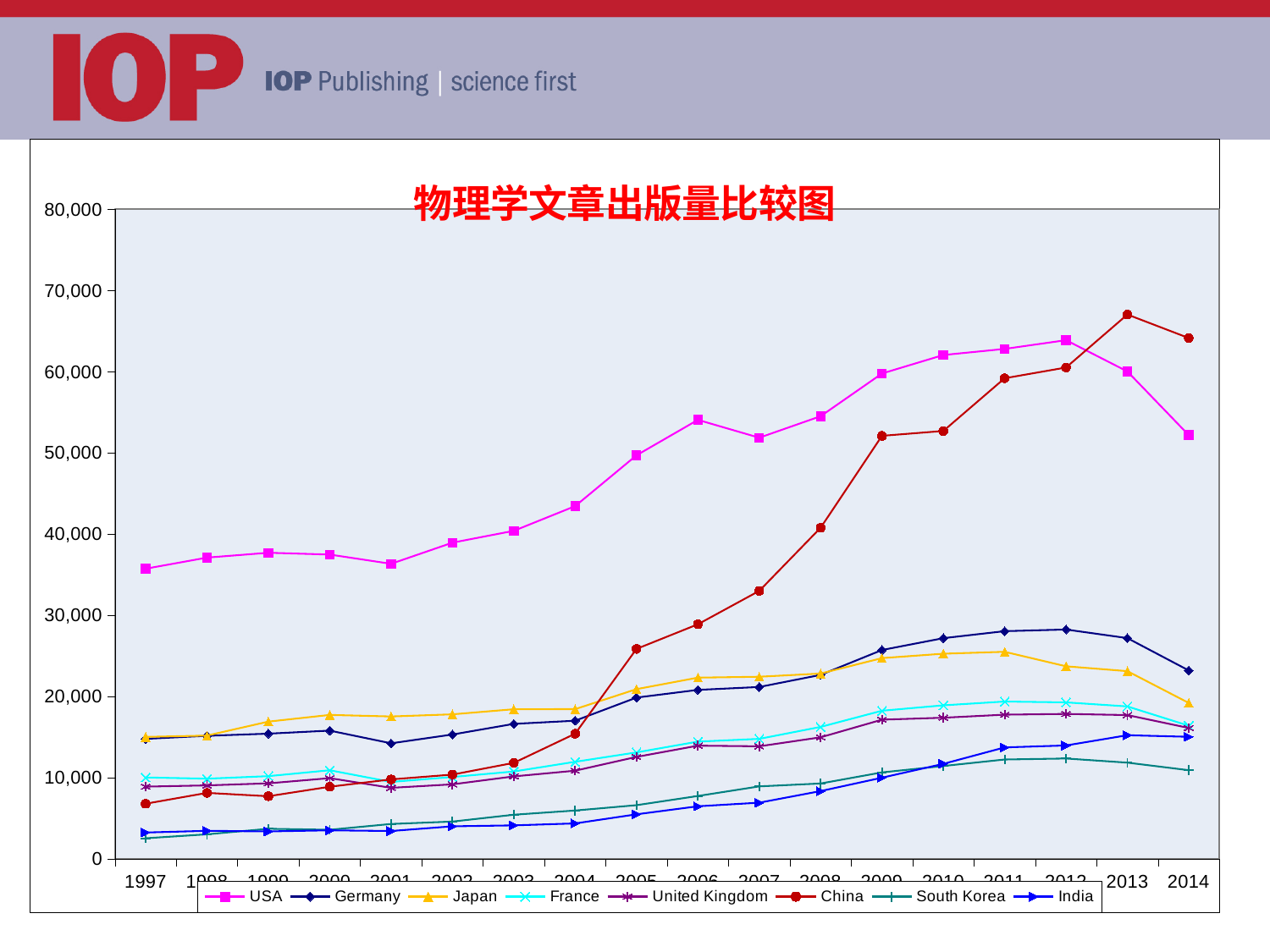
Which is larger in 2012, the value for USA or the value for China? USA Which country has the lowest value in 2014? South Korea How many years are plotted along the x axis? 18 Which country has the highest value in 2014? China Is the value for China in 1997 greater or less than 10,000? less How many series does the legend list? 8 Which is larger in 2013, the value for USA or the value for China? China In which year does China reach its highest value? 2013 Does the value for China rise or fall from 1997 to 2013? rise What kind of chart is shown on the slide? line chart Is the value for USA in 2014 greater or less than 50,000? greater Which country has the highest value in 1997? USA